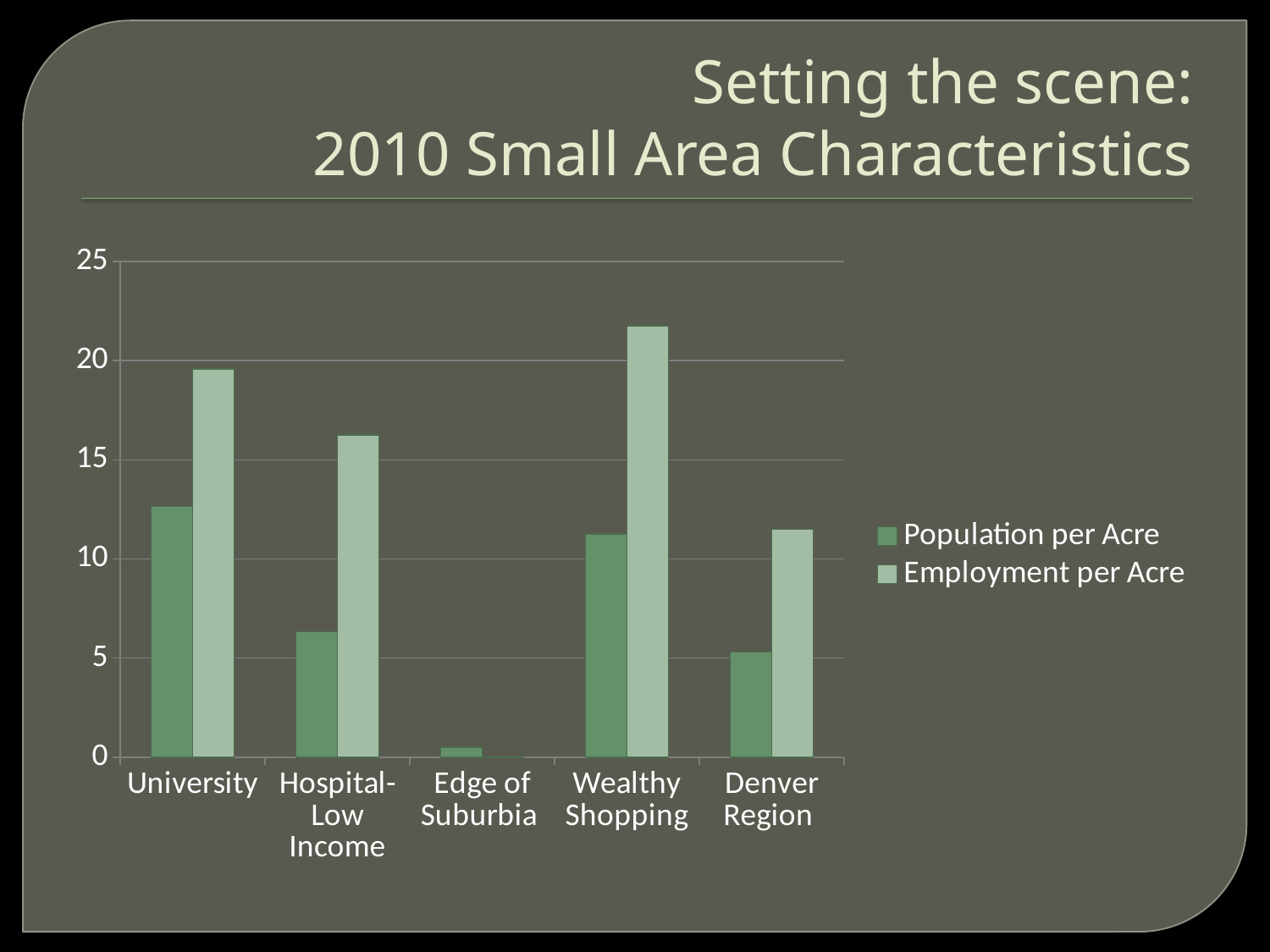
How many series does the chart's legend list? 2 Is the Employment per Acre value for University greater or less than 15? greater For Denver Region, which is larger: Population per Acre or Employment per Acre? Employment per Acre How many area categories are shown on the x axis of the chart? 5 Is the Employment per Acre value for Wealthy Shopping greater or less than 20? greater Is the Population per Acre value for Hospital-Low Income greater or less than 5? greater Which area has the lowest Population per Acre? Edge of Suburbia What kind of chart is shown on the slide? bar chart Which area has the highest Population per Acre? University Which area has the highest Employment per Acre? Wealthy Shopping What are the two series named in the chart's legend? Population per Acre and Employment per Acre